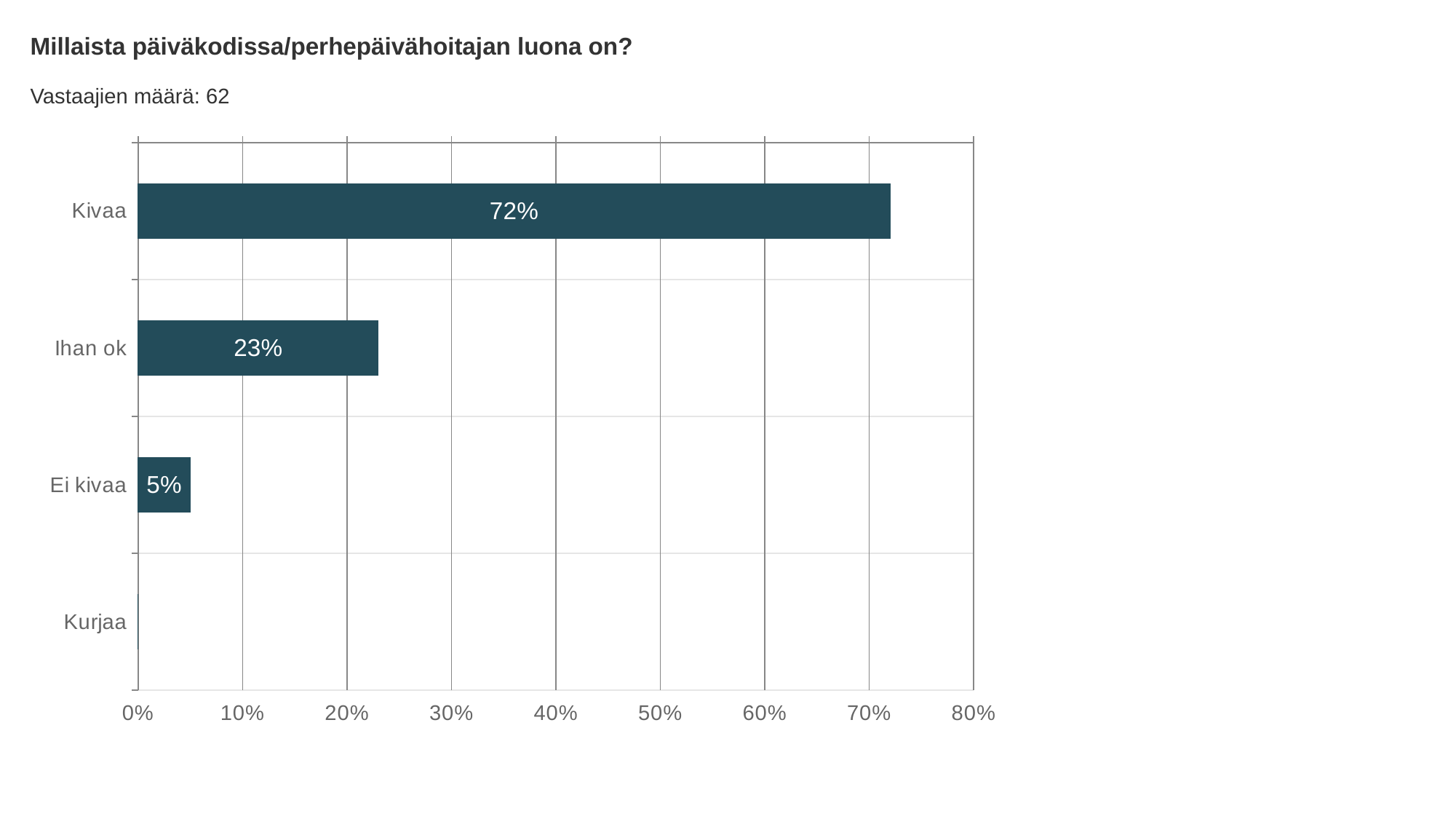
Which category has the lowest value? Kurjaa What kind of chart is shown on the slide? bar chart What is the difference between the values for Ihan ok and Ei kivaa? 18% Is the value for Kivaa greater or less than 70%? greater Which is larger, the value for Ihan ok or the value for Ei kivaa? Ihan ok What is the value for Ei kivaa? 5% Which category has the highest value? Kivaa How many categories are shown on the chart? 4 What is the value for Kivaa? 72% What is the value for Ihan ok? 23% What is the title of the chart? Millaista päiväkodissa/perhepäivähoitajan luona on? What is the difference between the values for Kivaa and Ihan ok? 49%